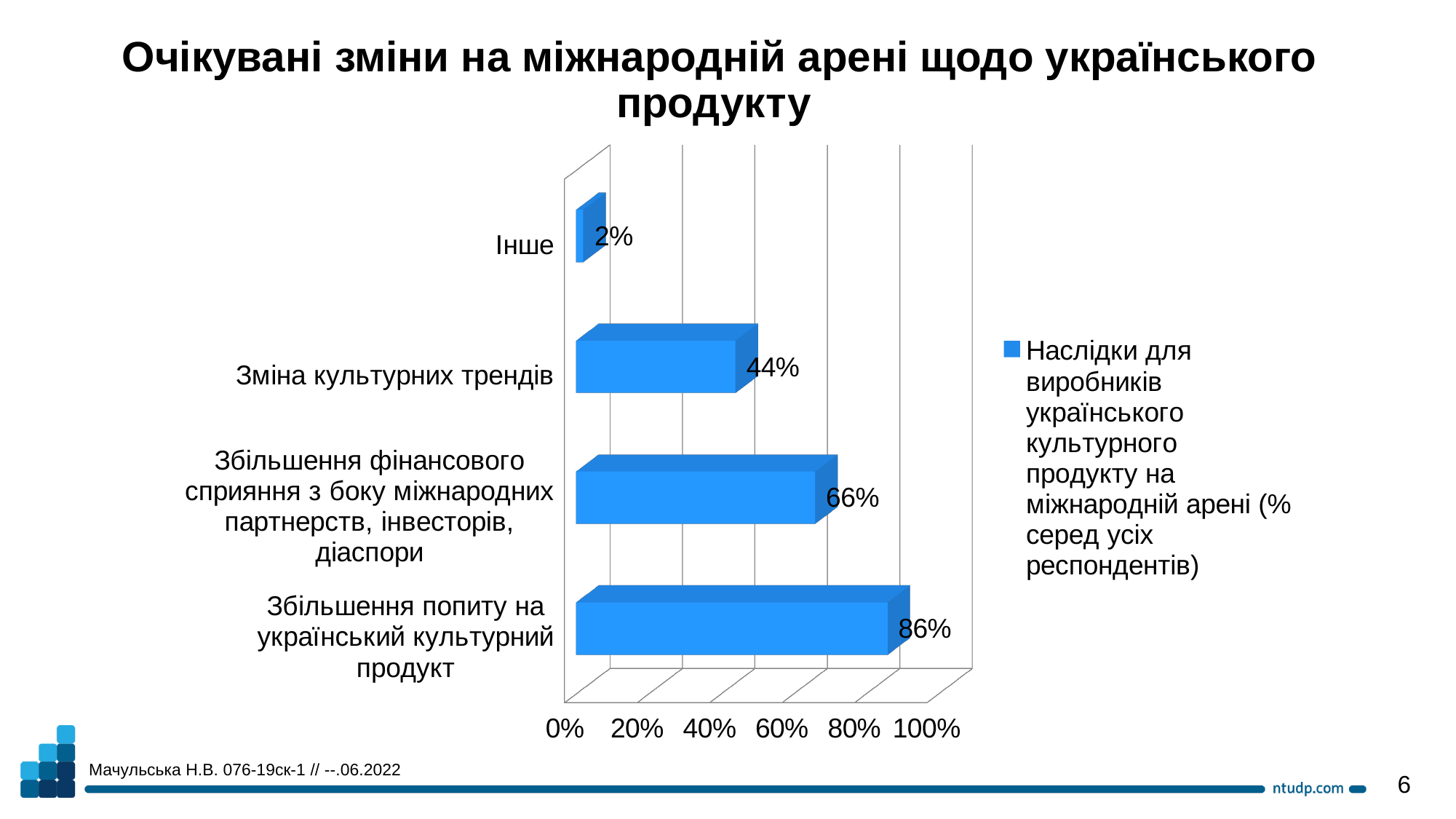
What is the value for "Інше"? 2% How many categories are shown in the chart? 4 Is the value for "Збільшення фінансового сприяння з боку міжнародних партнерств, інвесторів, діаспори" greater or less than 60%? greater Which category has the lowest value? Інше How many series does the legend list? 1 What is the value for "Зміна культурних трендів"? 44% What is the value for "Збільшення фінансового сприяння з боку міжнародних партнерств, інвесторів, діаспори"? 66% Which is larger: the value for "Зміна культурних трендів" or the value for "Збільшення фінансового сприяння з боку міжнародних партнерств, інвесторів, діаспори"? Збільшення фінансового сприяння з боку міжнародних партнерств, інвесторів, діаспори Which category has the highest value? Збільшення попиту на український культурний продукт What is the difference between the values for "Збільшення попиту на український культурний продукт" and "Зміна культурних трендів"? 42% What is the value for "Збільшення попиту на український культурний продукт"? 86% What kind of chart is shown on the slide? bar chart